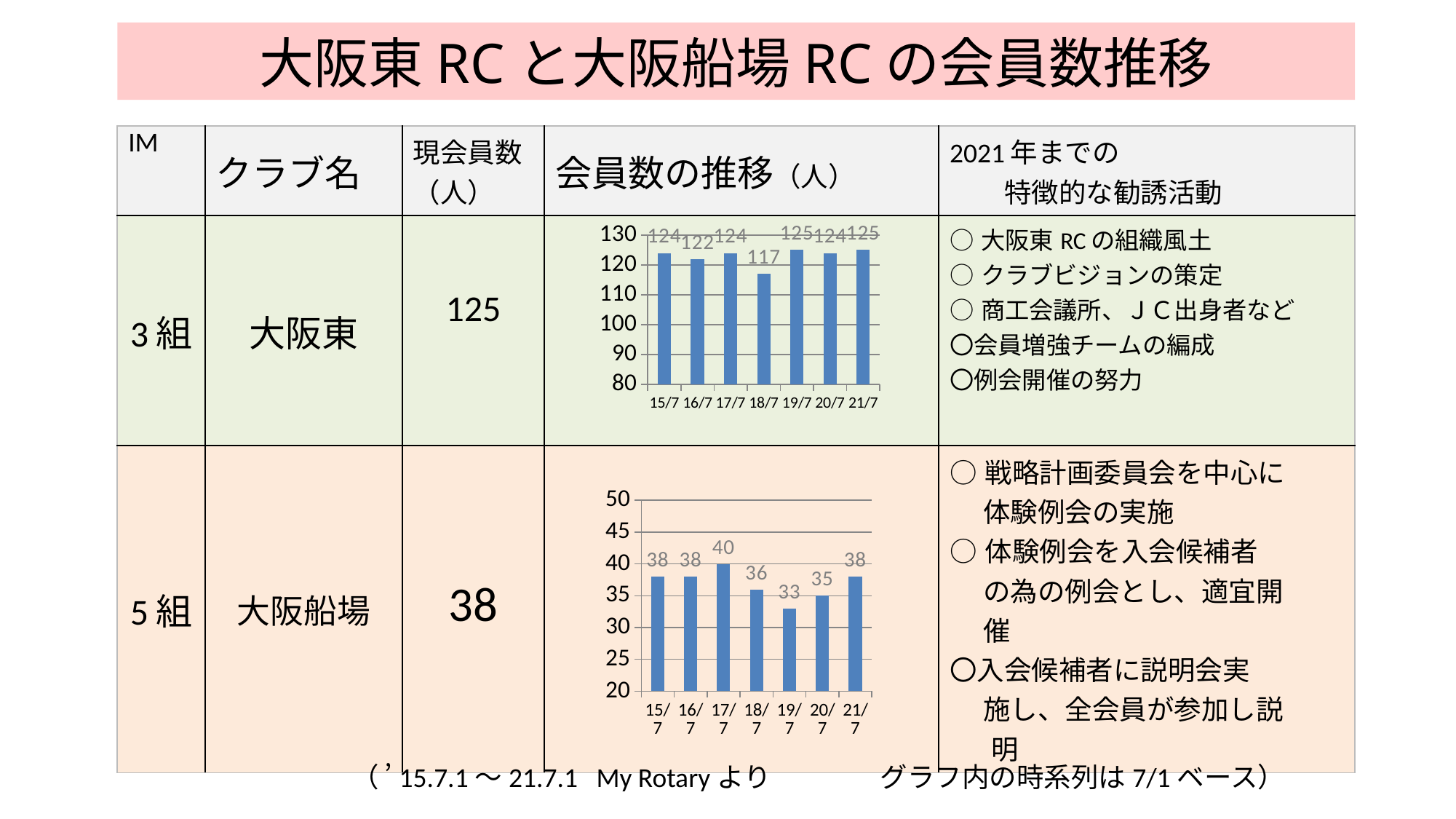
In the bottom chart (大阪船場 row), is the value for 20/7 larger or smaller than the value for 21/7? smaller In the top chart (大阪東 row), what is the value for 18/7? 117 In the bottom chart (大阪船場 row), what is the value for 17/7? 40 In the bottom chart (大阪船場 row), which category has the lowest value? 19/7 In the top chart (大阪東 row), which category has the lowest value? 18/7 What type of chart is used in the 大阪船場 row? bar chart In the top chart (大阪東 row), how many bars are plotted? 7 In the bottom chart (大阪船場 row), what is the difference between the values for 17/7 and 19/7? 7 In the bottom chart (大阪船場 row), which category has the highest value? 17/7 In the top chart (大阪東 row), what is the value for 16/7? 122 In the top chart (大阪東 row), what is the difference between the values for 19/7 and 18/7? 8 In the bottom chart (大阪船場 row), what is the value for 19/7? 33